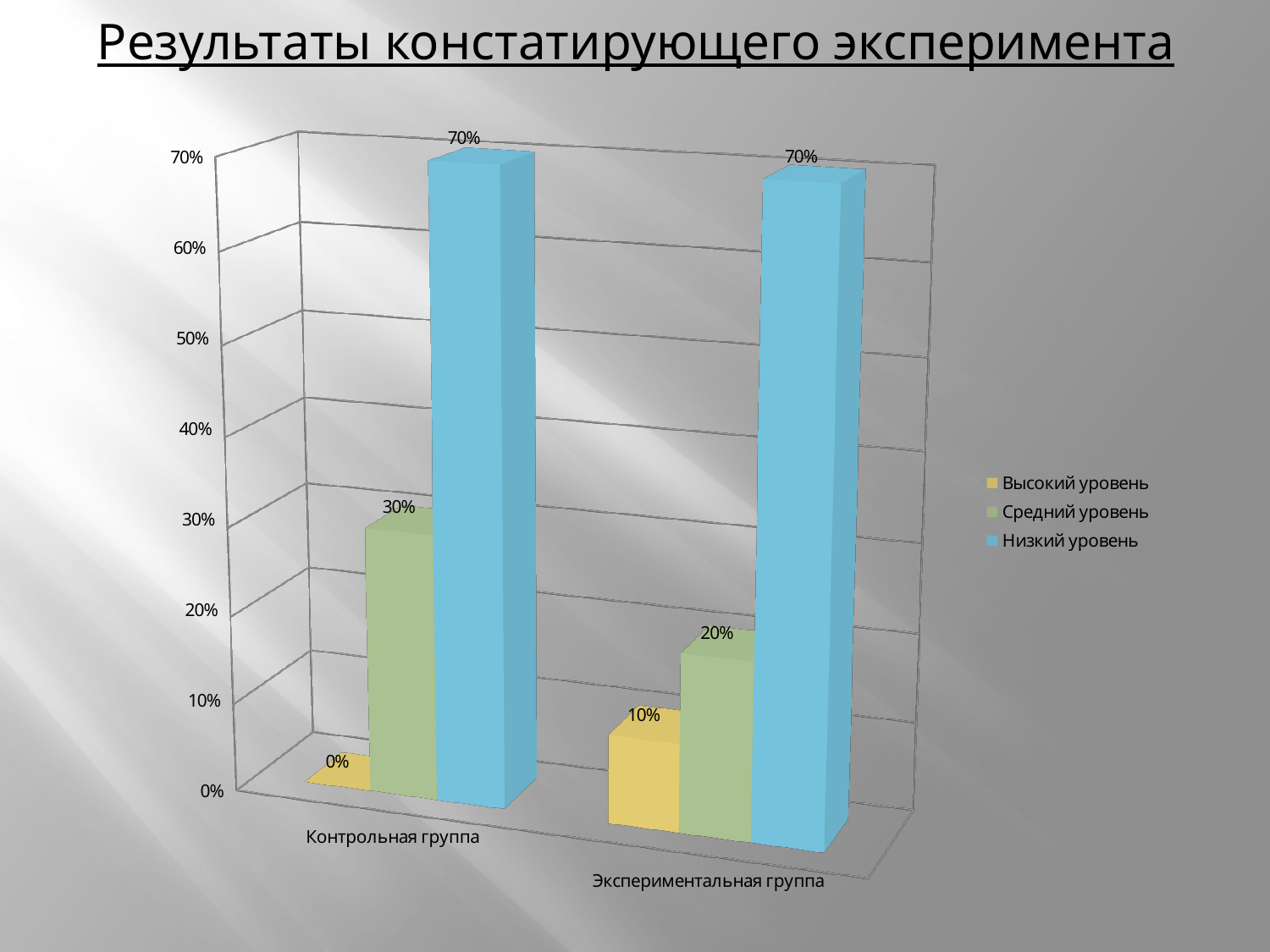
What is the value for Высокий уровень in the Экспериментальная группа? 10% What is the value for Высокий уровень in the Контрольная группа? 0% Which series has the lowest value in the Контрольная группа? Высокий уровень What kind of chart is shown on the slide? Bar chart How many groups (categories) are shown on the x axis? 2 Which series has the highest value in the Экспериментальная группа? Низкий уровень Which is larger: Высокий уровень in the Контрольная группа or Высокий уровень in the Экспериментальная группа? Экспериментальная группа What is the value for Низкий уровень in the Контрольная группа? 70% What is the difference between Средний уровень in the Контрольная группа and Средний уровень in the Экспериментальная группа? 10% How many series does the legend list? 3 What is the value for Средний уровень in the Экспериментальная группа? 20% What is the value for Средний уровень in the Контрольная группа? 30%